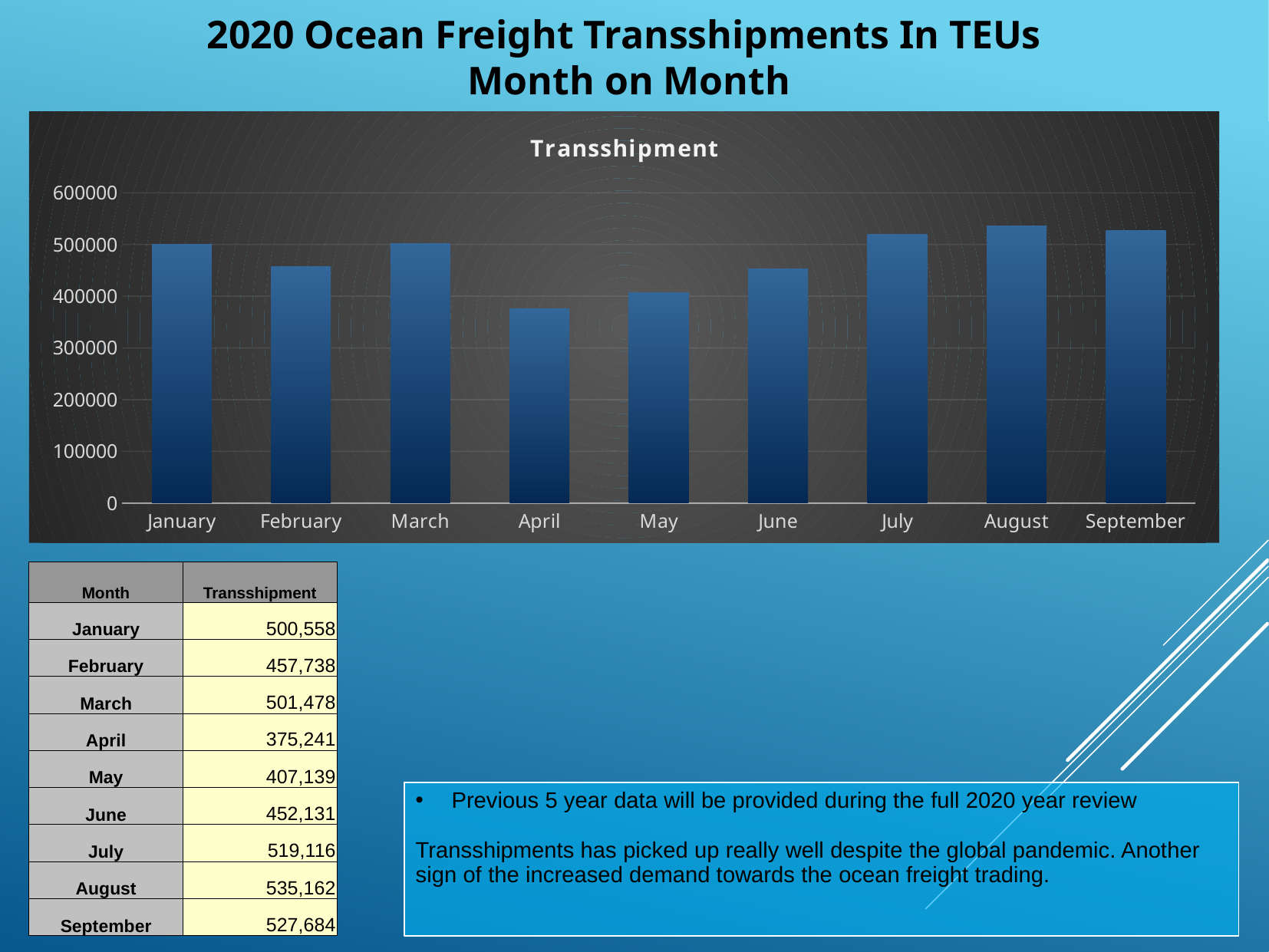
What is the transshipment value for April? 375,241 What is the difference between the transshipment values for August and April? 159,921 Do the transshipment values rise or fall from April to August? rise Is the transshipment value for April greater or less than 400000? less Which month has the lowest transshipment value? April What is the difference between the transshipment values for July and June? 66,985 What type of chart is shown on the slide? bar chart What is the transshipment value for August? 535,162 Which month has the highest transshipment value? August What is the transshipment value for September? 527,684 Which month has a larger transshipment value, July or May? July How many months are plotted in the Transshipment chart? 9